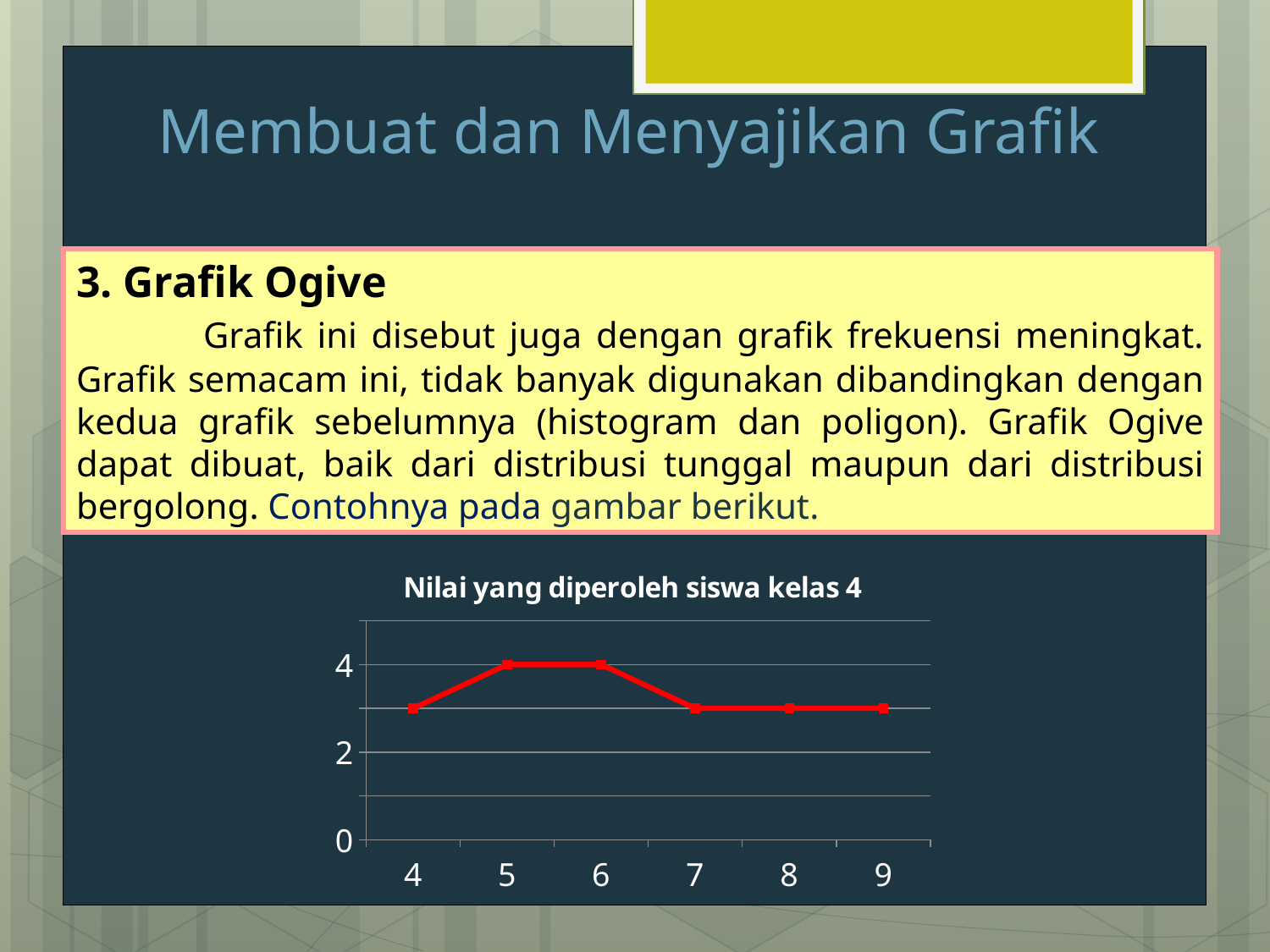
Is the value at x = 9 greater or less than 2? greater What is the title of the chart? Nilai yang diperoleh siswa kelas 4 What type of chart is shown on the slide? line chart Which is larger, the value at x = 5 or the value at x = 4? x = 5 How many data points are plotted on the line? 6 Is the value at x = 7 greater or less than 4? less What is the value at x = 6? 4 Does the line rise or fall between x = 6 and x = 7? fall Is the value at x = 4 greater or less than 2? greater Which is larger, the value at x = 6 or the value at x = 8? x = 6 Does the line rise or fall between x = 4 and x = 5? rise What is the value at x = 5? 4